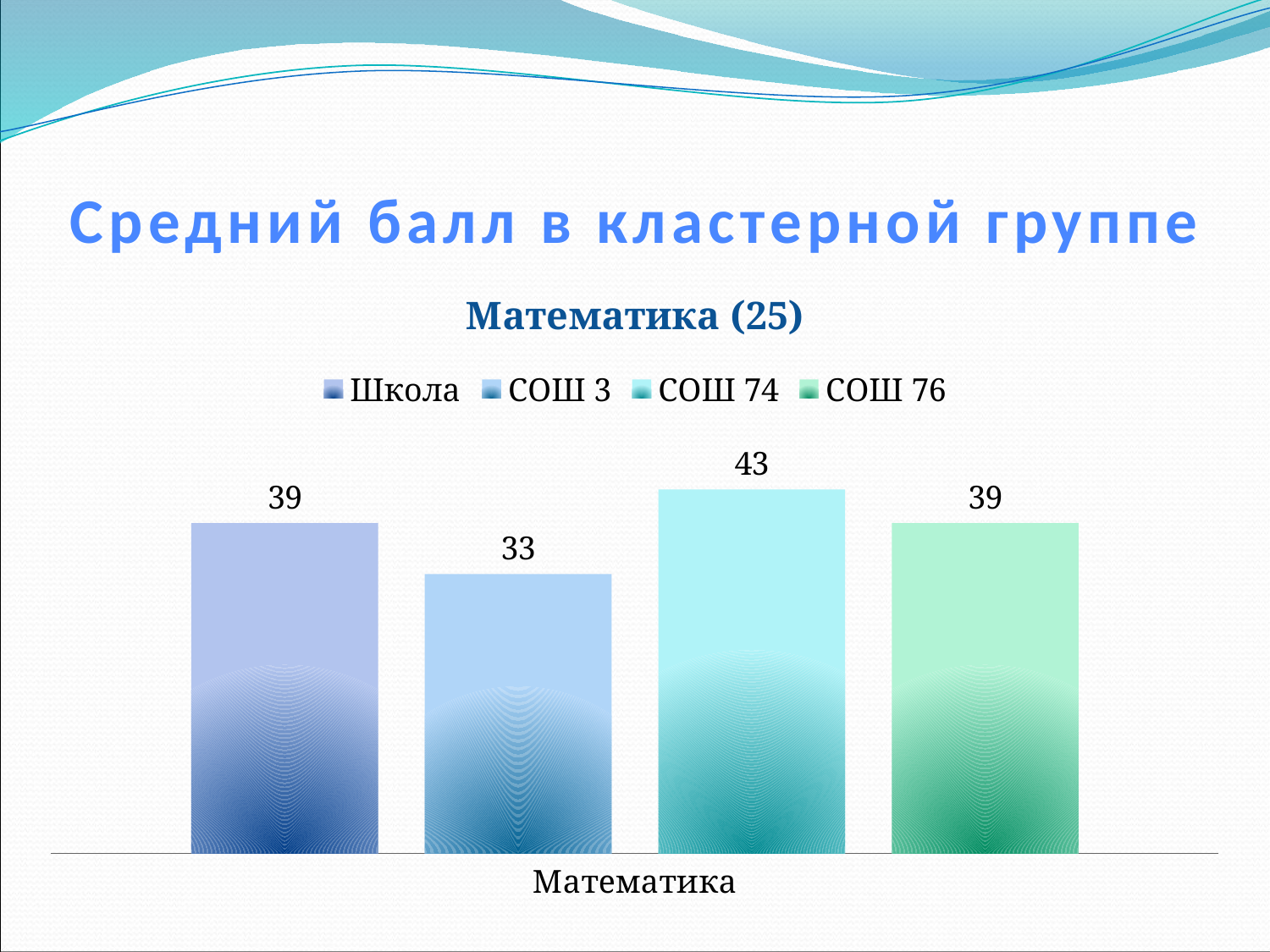
What is the difference between the values for Школа and СОШ 3? 6 What is the value for СОШ 74 in the Математика (25) chart? 43 What kind of chart is shown on the slide? Bar chart How many series does the legend list? 4 What is the value for Школа in the Математика (25) chart? 39 Which series has the lowest value in the Математика (25) chart? СОШ 3 What is the title of the chart? Математика (25) Which series has the highest value in the Математика (25) chart? СОШ 74 What is the value for СОШ 76 in the Математика (25) chart? 39 What is the value for СОШ 3 in the Математика (25) chart? 33 What is the difference between the values for СОШ 74 and СОШ 3? 10 Which is larger, the value for СОШ 74 or the value for СОШ 76? СОШ 74